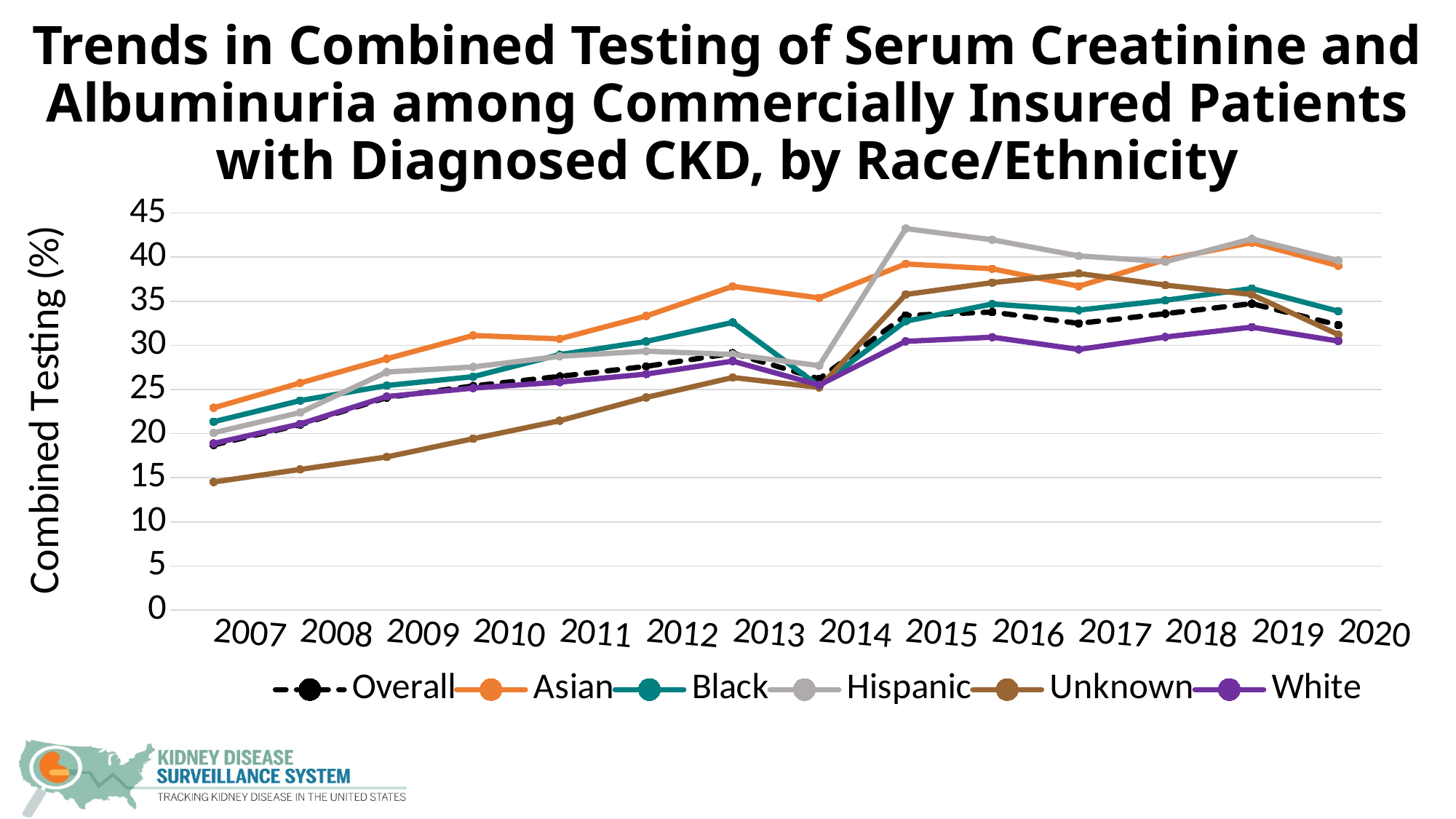
Is the value for Hispanic in 2015 greater or less than 40? greater Which series has the lowest value in 2007? Unknown Which is larger in 2012, the value for Asian or the value for Black? Asian Which series has the lowest value in 2010? Unknown Does the Unknown series rise or fall from 2007 to 2013? rise What is the label on the y axis? Combined Testing (%) How many years are shown along the x axis? 14 What kind of chart is shown on the slide? line chart How many series does the legend list? 6 Which series has the highest value in 2015? Hispanic Is the value for Unknown in 2007 greater or less than 15? less Which series has the highest value in 2007? Asian